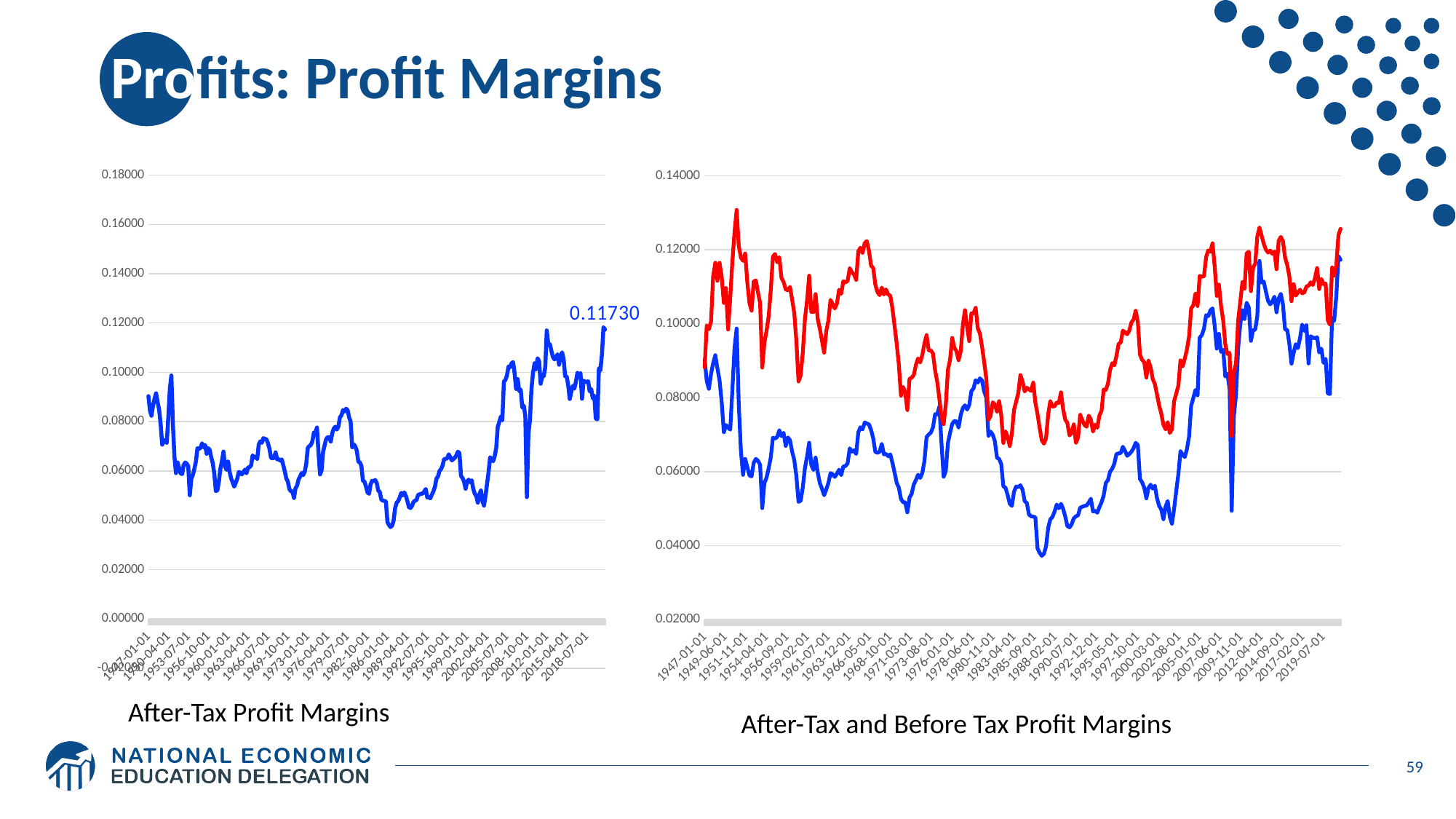
What kind of chart is the After-Tax Profit Margins chart on the left? line chart On the After-Tax Profit Margins chart, what value is printed as the data label at the end of the series? 0.11730 On the After-Tax and Before Tax Profit Margins chart, is the blue line's value around 1988-02-01 greater or less than 0.06000? less On the After-Tax and Before Tax Profit Margins chart, what is the lowest value shown on the y axis? 0.02000 On the After-Tax Profit Margins chart, is the final labelled value greater or less than 0.10000? greater On the After-Tax and Before Tax Profit Margins chart, is the red line's peak around 1951-11-01 greater or less than 0.12000? greater How many lines are plotted on the After-Tax and Before Tax Profit Margins chart? 2 What kind of chart is the After-Tax and Before Tax Profit Margins chart on the right? line chart On the After-Tax Profit Margins chart, do the values generally rise or fall between 2002-04-01 and 2018-07-01? rise On the After-Tax Profit Margins chart, what is the highest value shown on the y axis? 0.18000 On the After-Tax and Before Tax Profit Margins chart, which line is generally higher, the red line or the blue line? the red line